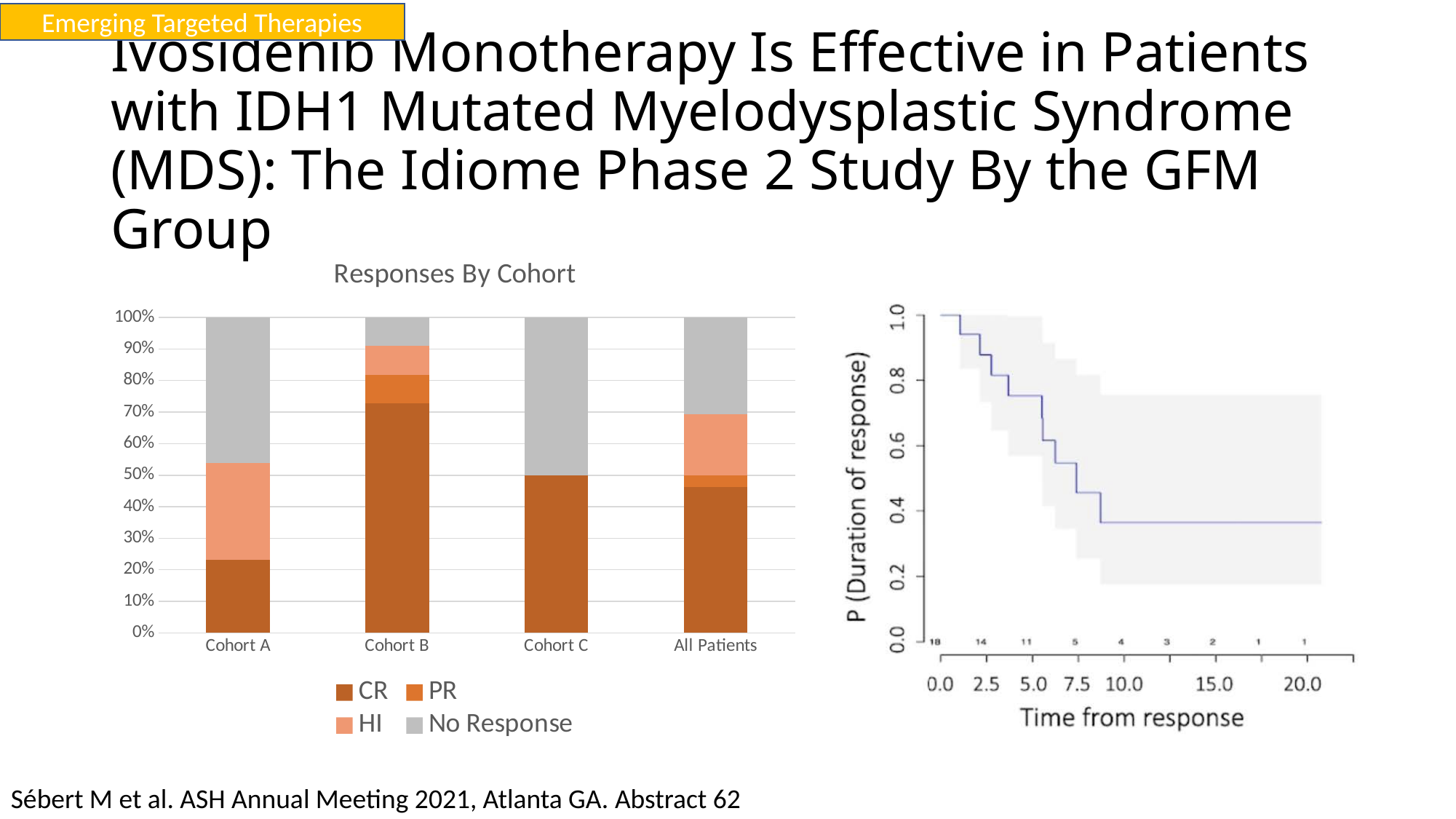
What is the x-axis label of the curve chart on the right of the slide? Time from response In the 'Responses By Cohort' chart, is the CR value for Cohort B greater or less than 70%? greater In the 'Responses By Cohort' chart, which has the larger No Response share, Cohort A or Cohort B? Cohort A In the 'Responses By Cohort' chart, is the No Response value for Cohort B greater or less than 20%? less In the 'Responses By Cohort' chart, is the No Response value for All Patients greater or less than 40%? less In the 'Responses By Cohort' chart, which category has the lowest CR value? Cohort A In the 'Responses By Cohort' chart, which category has the highest CR value? Cohort B What is the title of the bar chart on the left of the slide? Responses By Cohort What kind of chart is the 'Responses By Cohort' chart on the left? bar chart How many categories are shown on the x axis of the 'Responses By Cohort' chart? 4 How many series does the legend of the 'Responses By Cohort' chart list? 4